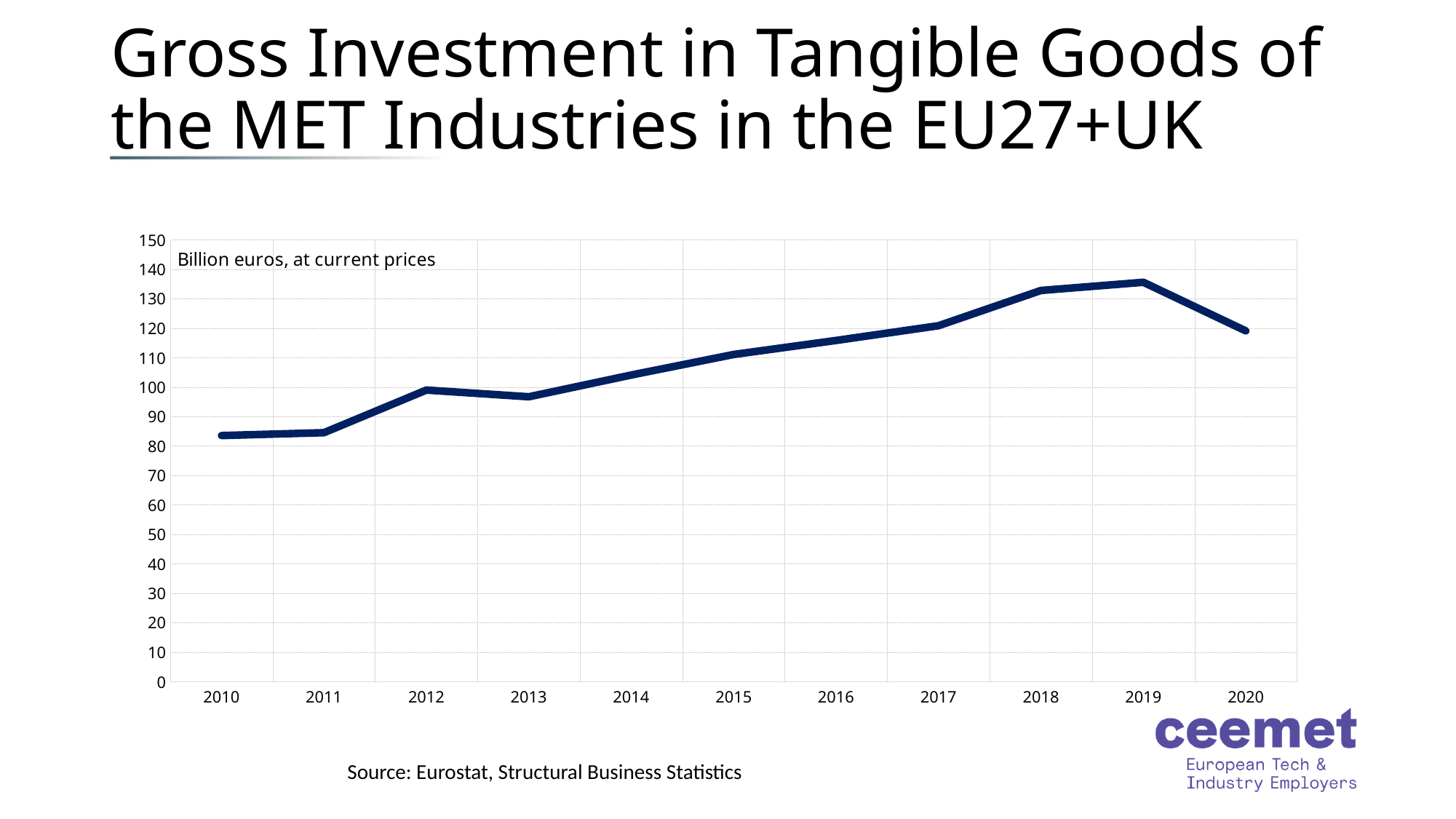
In which year is gross investment highest? 2019 Is the value for 2020 greater or less than 110? greater Is the value for 2016 greater or less than 120? less Which year has the larger value, 2010 or 2012? 2012 Is the value for 2014 greater or less than 100? greater Does the value rise or fall between 2019 and 2020? fall What unit is stated on the chart for the plotted values? Billion euros, at current prices Which year has the larger value, 2018 or 2020? 2018 What kind of chart is shown on the slide? line chart How many years are plotted on the x axis? 11